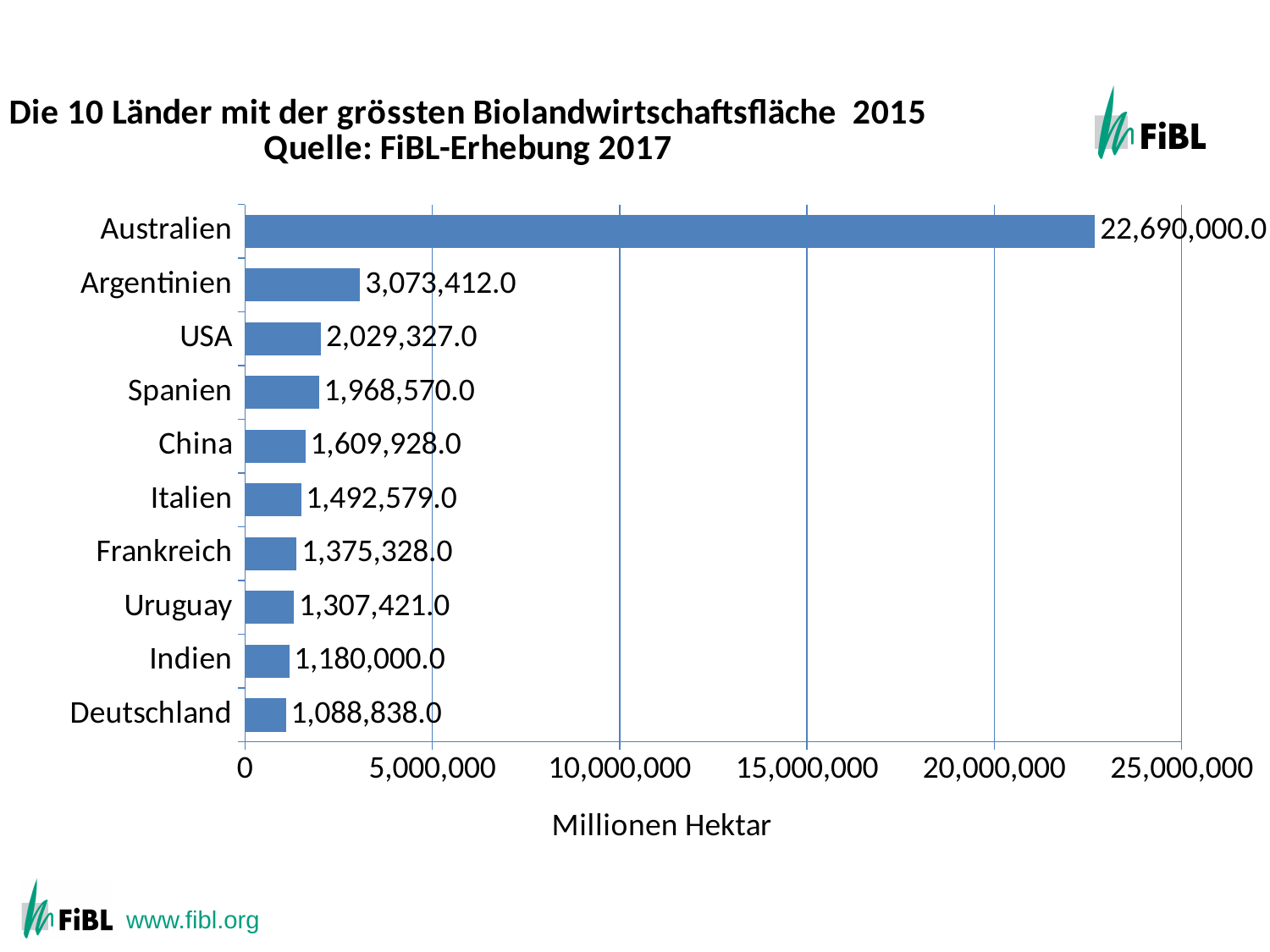
What kind of chart is shown on the slide? bar chart What is the value for Uruguay? 1,307,421.0 Is the value for Australien greater or less than 20,000,000? greater What is the label of the horizontal axis? Millionen Hektar What is the value for Australien? 22,690,000.0 How many countries are shown in the chart? 10 Which is larger, the value for China or the value for Italien? China Which country has the largest value? Australien What is the difference between the values for Indien and Deutschland? 91,162.0 What is the value for Spanien? 1,968,570.0 What is the difference between the values for Argentinien and USA? 1,044,085.0 Which country has the smallest value? Deutschland